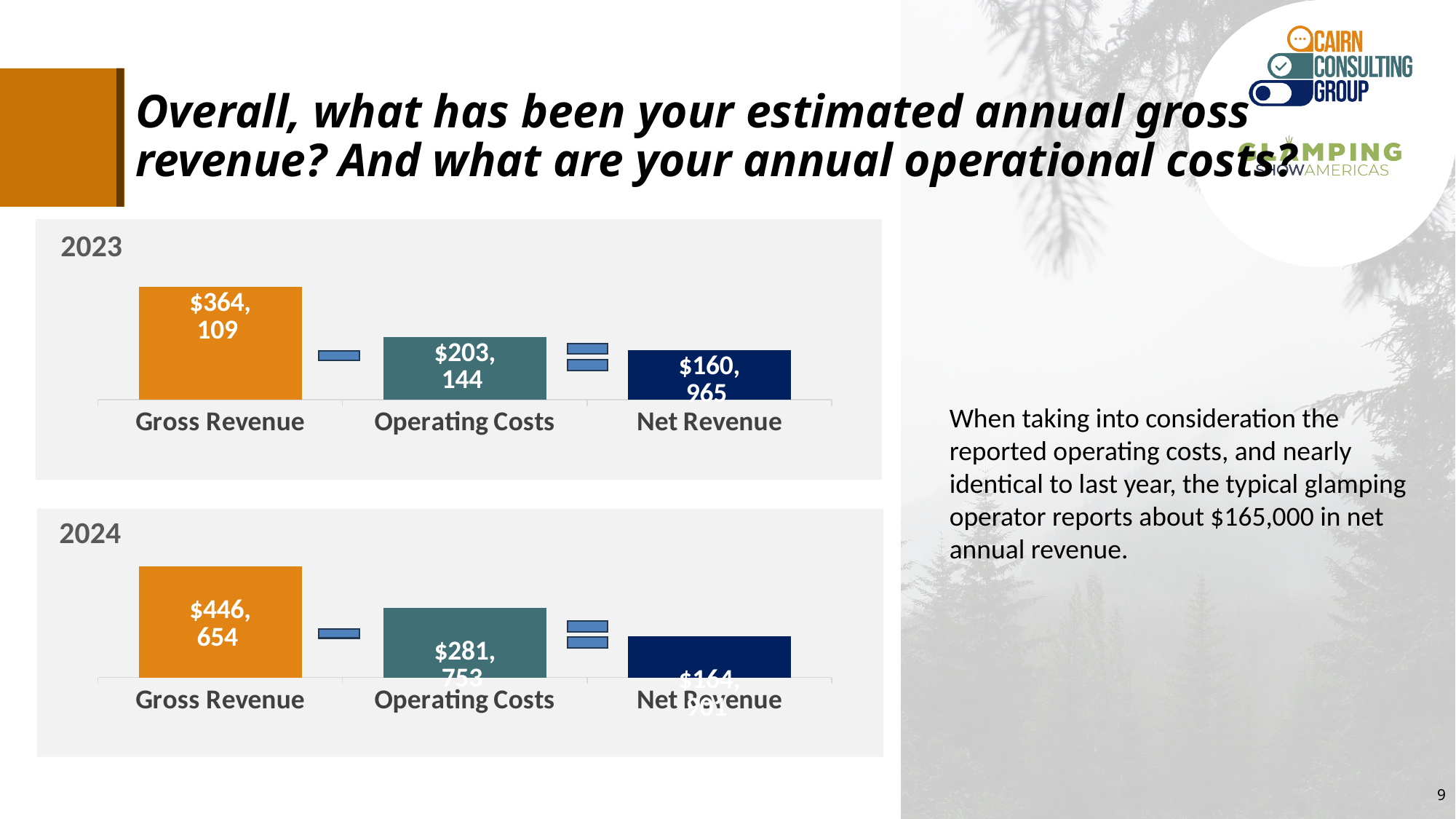
In the 2024 chart, what is the value for Gross Revenue? $446,654 In the 2023 chart, what is the value for Net Revenue? $160,965 In the 2023 chart, what is the value for Operating Costs? $203,144 In the 2023 chart, which category has the highest value? Gross Revenue Is Gross Revenue larger in the 2023 chart or the 2024 chart? 2024 In the 2023 chart, what is the value for Gross Revenue? $364,109 In the 2023 chart, what is the difference between Gross Revenue and Operating Costs? $160,965 In the 2024 chart, what is the difference between Gross Revenue and Operating Costs? $164,901 In the 2024 chart, which category has the lowest value? Net Revenue What kind of chart is the 2023 chart? Bar chart How many categories are shown in the 2024 chart? 3 In the 2024 chart, what is the value for Operating Costs? $281,753